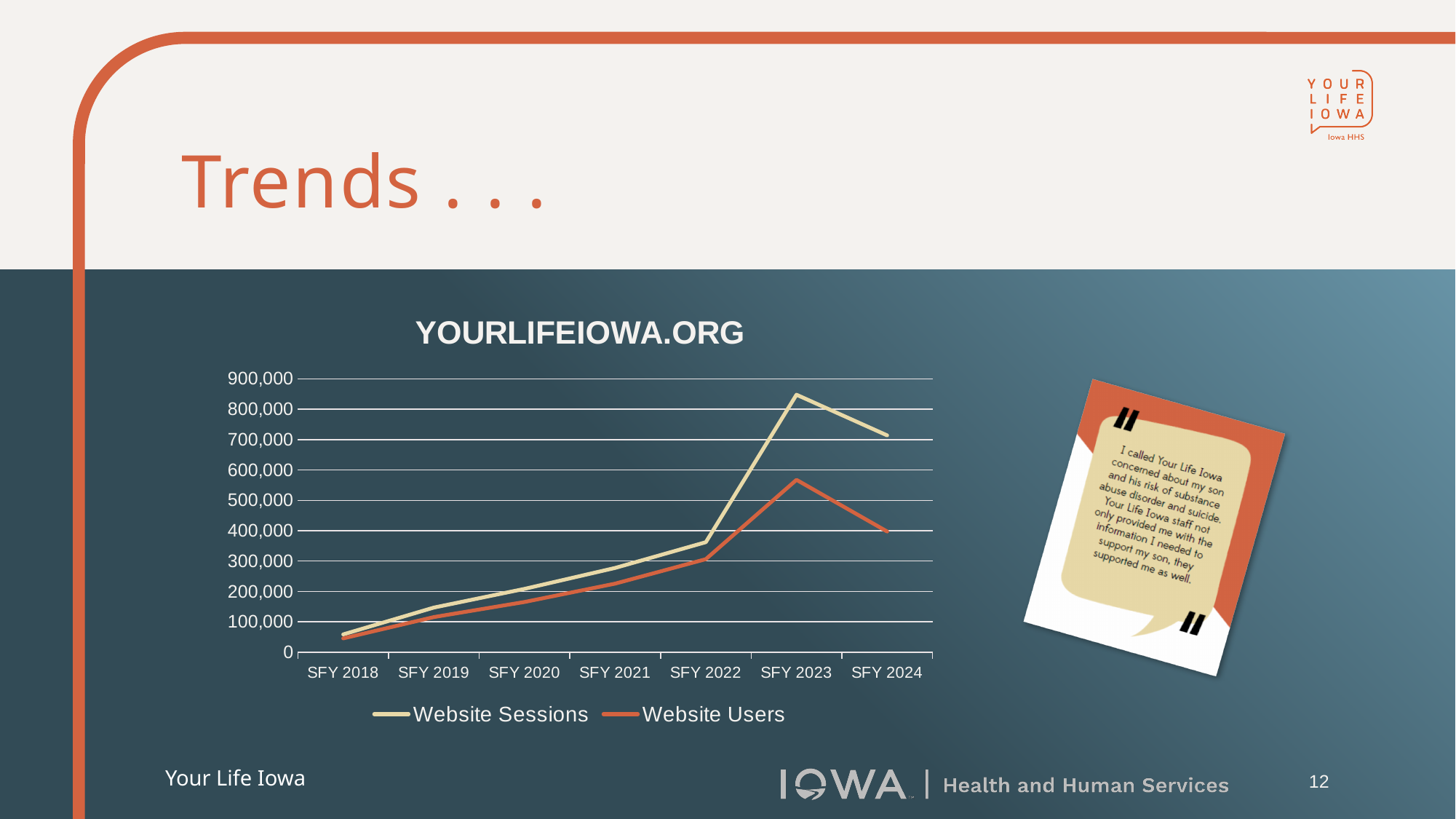
What kind of chart is shown on the slide? line chart Is the value for Website Users in SFY 2023 greater or less than 500,000? greater In SFY 2023, which is larger: Website Sessions or Website Users? Website Sessions In which fiscal year are Website Sessions lowest? SFY 2018 Do Website Sessions rise or fall from SFY 2018 to SFY 2023? rise What is the title of the chart? YOURLIFEIOWA.ORG In which fiscal year do Website Users peak? SFY 2023 Is the value for Website Sessions in SFY 2023 greater or less than 800,000? greater Is the value for Website Sessions in SFY 2022 greater or less than 400,000? less How many series does the legend of the YOURLIFEIOWA.ORG chart list? 2 In which fiscal year do Website Sessions reach their highest value? SFY 2023 How many fiscal years are plotted along the x axis of the chart? 7